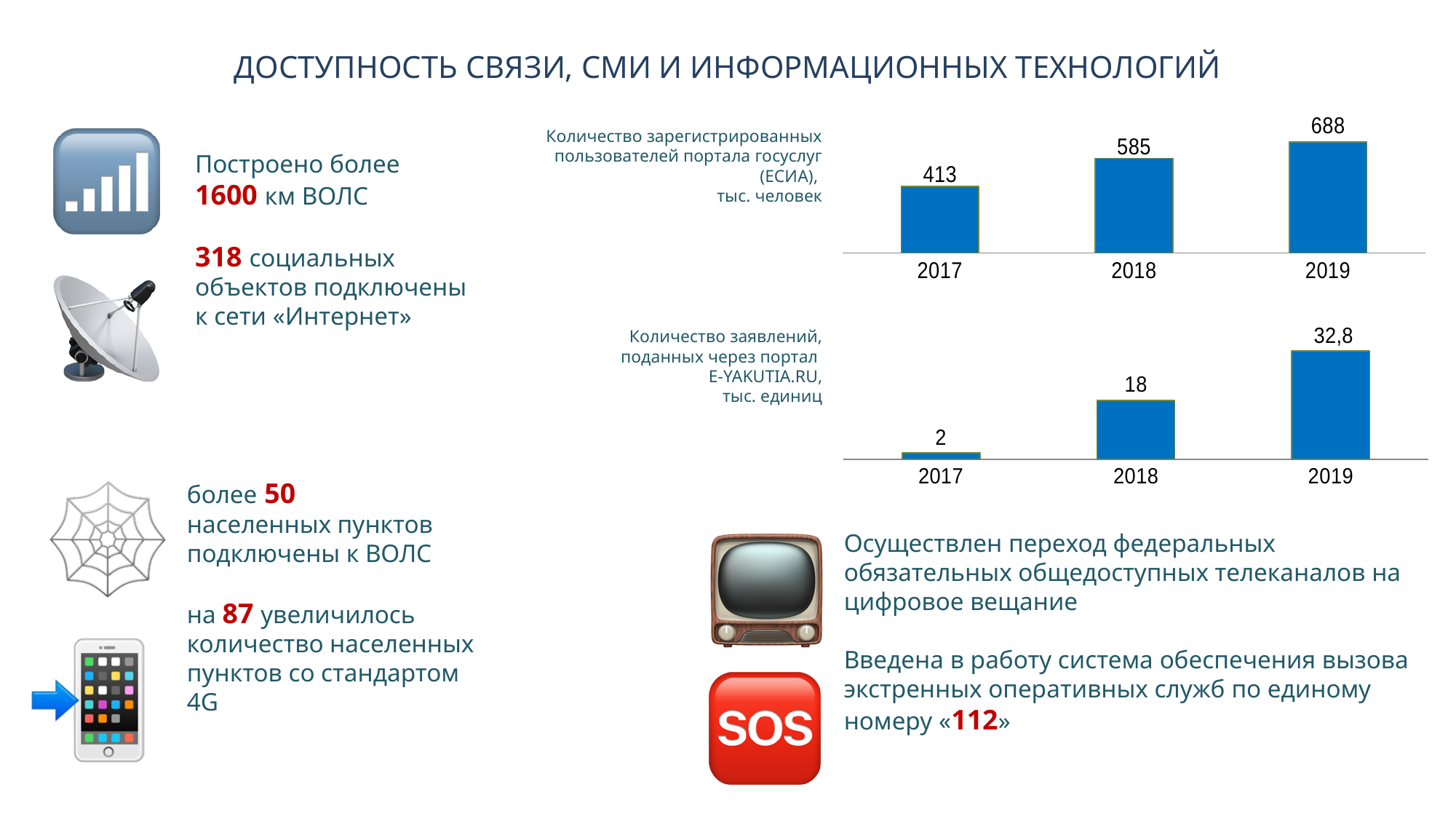
What type of chart is the bottom chart (applications submitted via the E-YAKUTIA.RU portal)? bar chart How many years are shown in the top chart (registered users of the gosuslugi portal, ESIA)? 3 In the top chart (registered users of the gosuslugi portal, ESIA), what is the value for 2017? 413 In the bottom chart (applications submitted via the E-YAKUTIA.RU portal), what is the difference between the 2018 and 2017 values? 16 In the top chart (registered users of the gosuslugi portal, ESIA), which year has the highest value? 2019 In the bottom chart (applications submitted via the E-YAKUTIA.RU portal), what is the value for 2019? 32,8 In the top chart (registered users of the gosuslugi portal, ESIA), what is the value for 2018? 585 In the bottom chart (applications submitted via the E-YAKUTIA.RU portal), which year has the lowest value? 2017 In the top chart (registered users of the gosuslugi portal, ESIA), what is the difference between the 2019 and 2017 values? 275 In the bottom chart (applications submitted via the E-YAKUTIA.RU portal), which is larger, the value for 2018 or 2019? 2019 In the top chart (registered users of the gosuslugi portal, ESIA), do the values rise or fall from 2017 to 2019? rise In the bottom chart (applications submitted via the E-YAKUTIA.RU portal), what is the value for 2017? 2